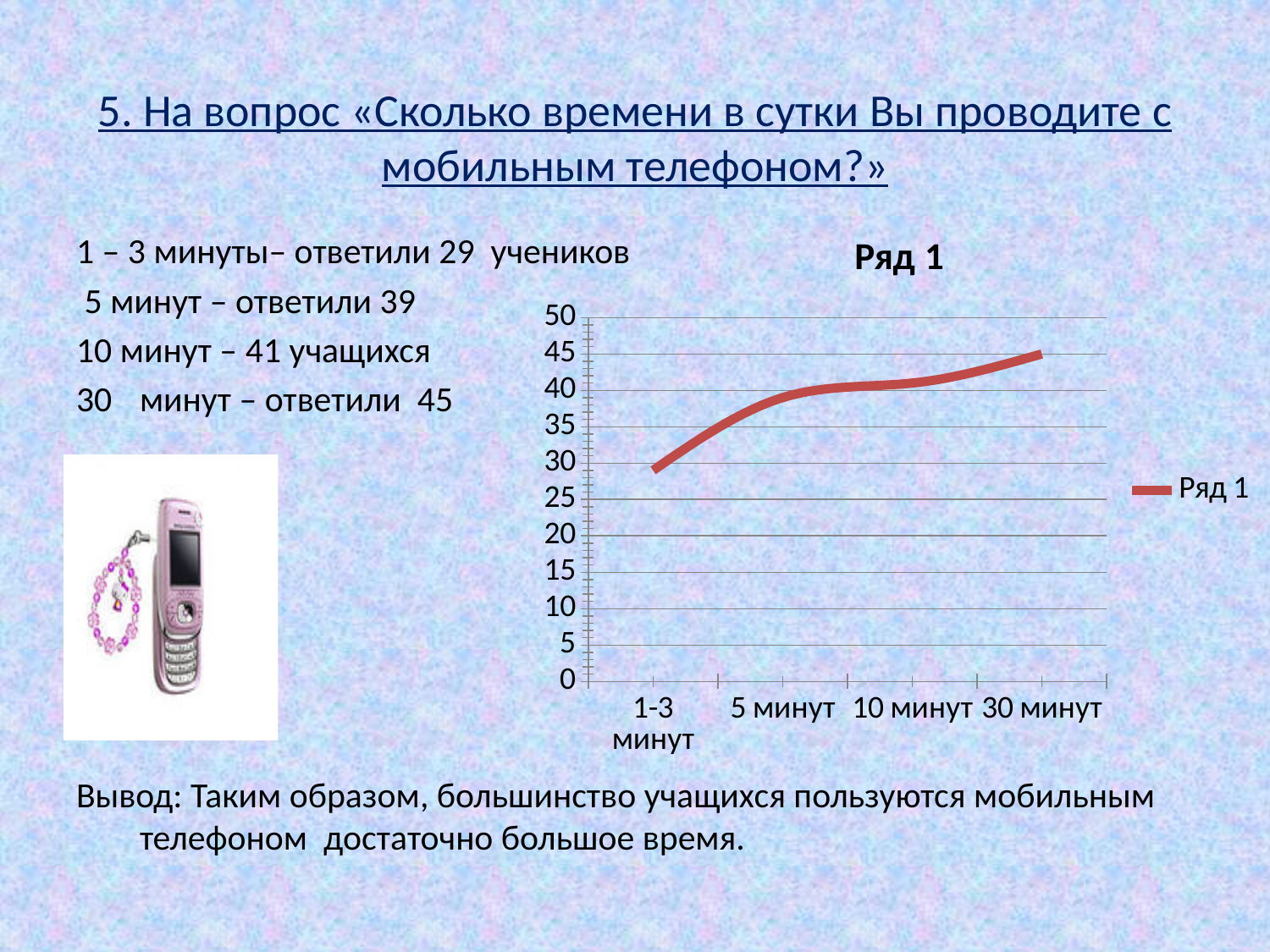
How many series does the legend list? 1 Is the value for 1-3 минут greater or less than 25? greater Which is larger, the value for 30 минут or the value for 1-3 минут? 30 минут How many categories are plotted along the x axis? 4 What kind of chart is shown on the slide? line chart Do the values rise or fall along the x axis from 1-3 минут to 30 минут? rise Is the value for 30 минут greater or less than 40? greater According to the slide, how many students answered 10 минут? 41 Is the value for 5 минут greater or less than 35? greater What is the title of the chart? Ряд 1 Which category has the highest value? 30 минут Which category has the lowest value? 1-3 минут